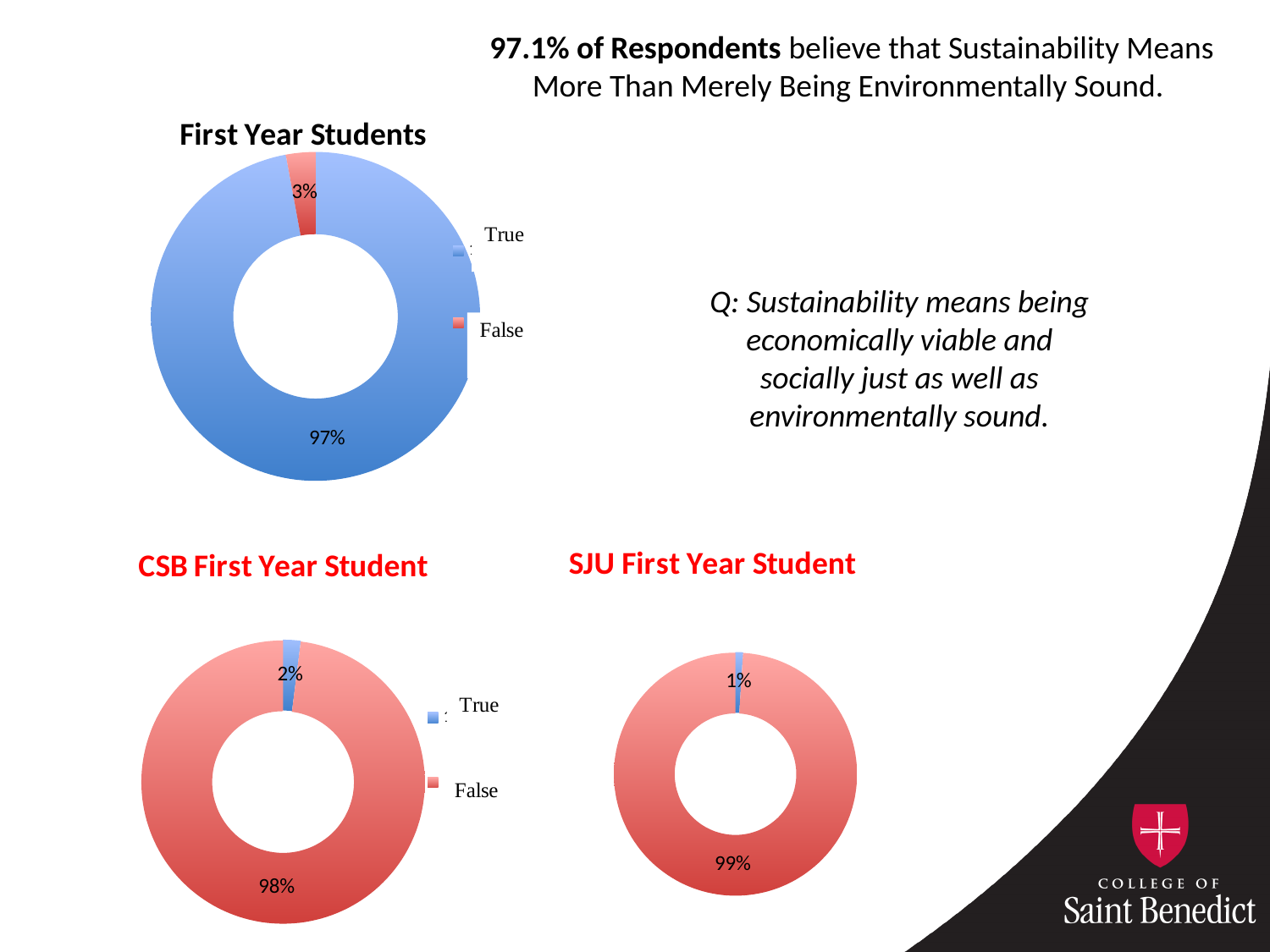
How many categories does the legend of the "First Year Students" chart list? 2 In the "First Year Students" chart, which category has the largest share? True In the "SJU First Year Student" chart, what percentage is shown on the largest slice? 99% In the "CSB First Year Student" chart, what percentage is shown on the smallest slice? 2% In the "SJU First Year Student" chart, what percentage is shown on the smallest slice? 1% In the "First Year Students" chart, what is the difference between the True and False percentages? 94% What kind of chart is the "First Year Students" chart? doughnut chart In the "CSB First Year Student" chart, what percentage is shown on the largest slice? 98% In the "First Year Students" chart, what percentage is shown for False? 3% In the "First Year Students" chart, what percentage is shown for True? 97% How many doughnut charts are shown on the slide? 3 Which is larger: the smallest slice in the "CSB First Year Student" chart or the smallest slice in the "SJU First Year Student" chart? CSB First Year Student